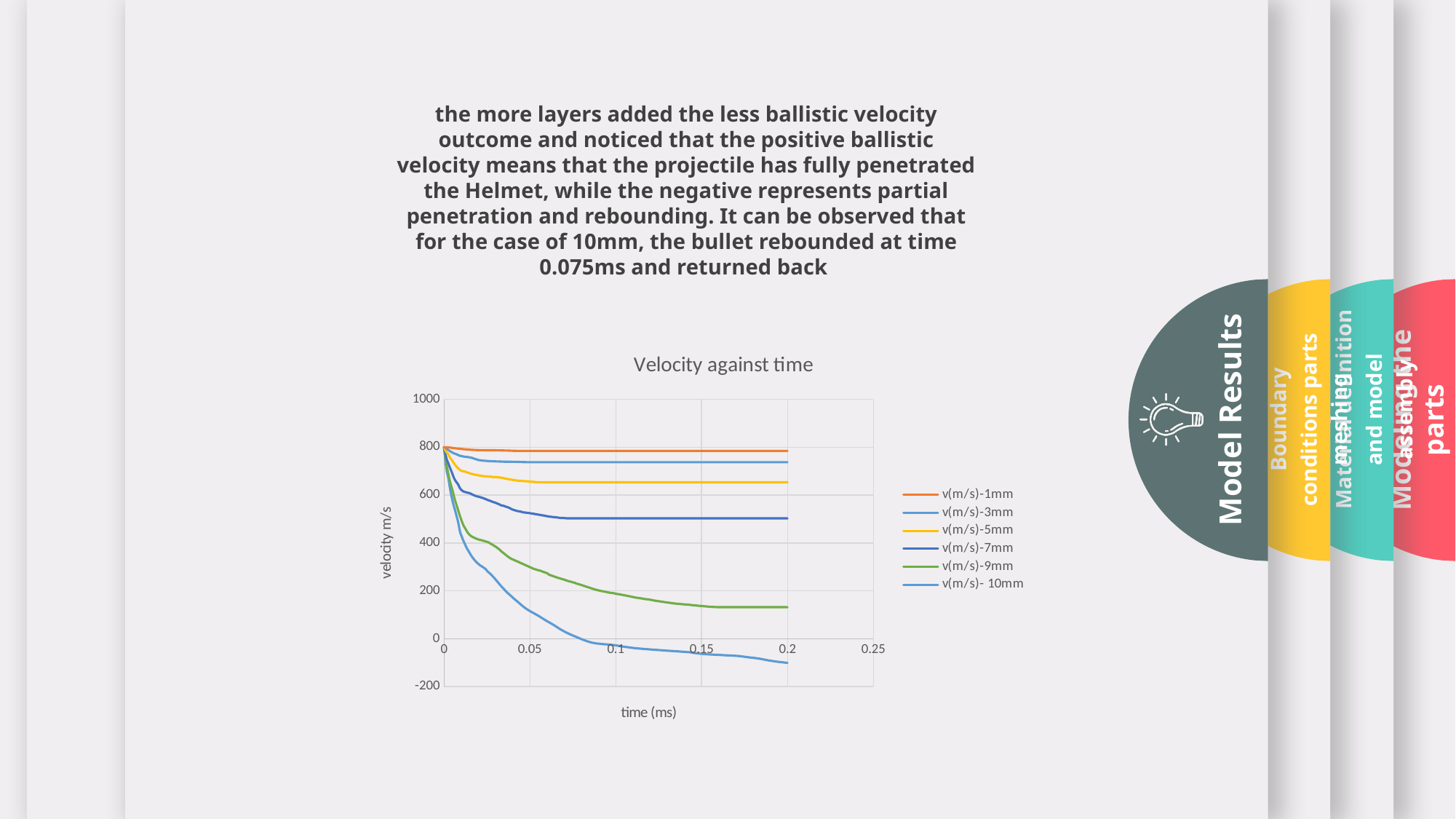
Does the velocity for the v(m/s)-9mm series rise or fall as time increases? fall What kind of chart is shown on the slide? line chart Is the velocity for the v(m/s)-1mm series at time 0.2 ms greater or less than 600? greater Is the velocity for the v(m/s)-9mm series at time 0.2 ms greater or less than 200? less Which series has the lowest velocity at time 0.2 ms? v(m/s)- 10mm What is the title of the chart? Velocity against time At time 0.2 ms, which series has the larger velocity, v(m/s)-5mm or v(m/s)-7mm? v(m/s)-5mm Which series has the highest velocity at time 0.2 ms? v(m/s)-1mm Is the velocity for the v(m/s)- 10mm series at time 0.2 ms greater or less than 0? less How many series does the legend of the chart list? 6 What is the label of the x axis of the chart? time (ms)